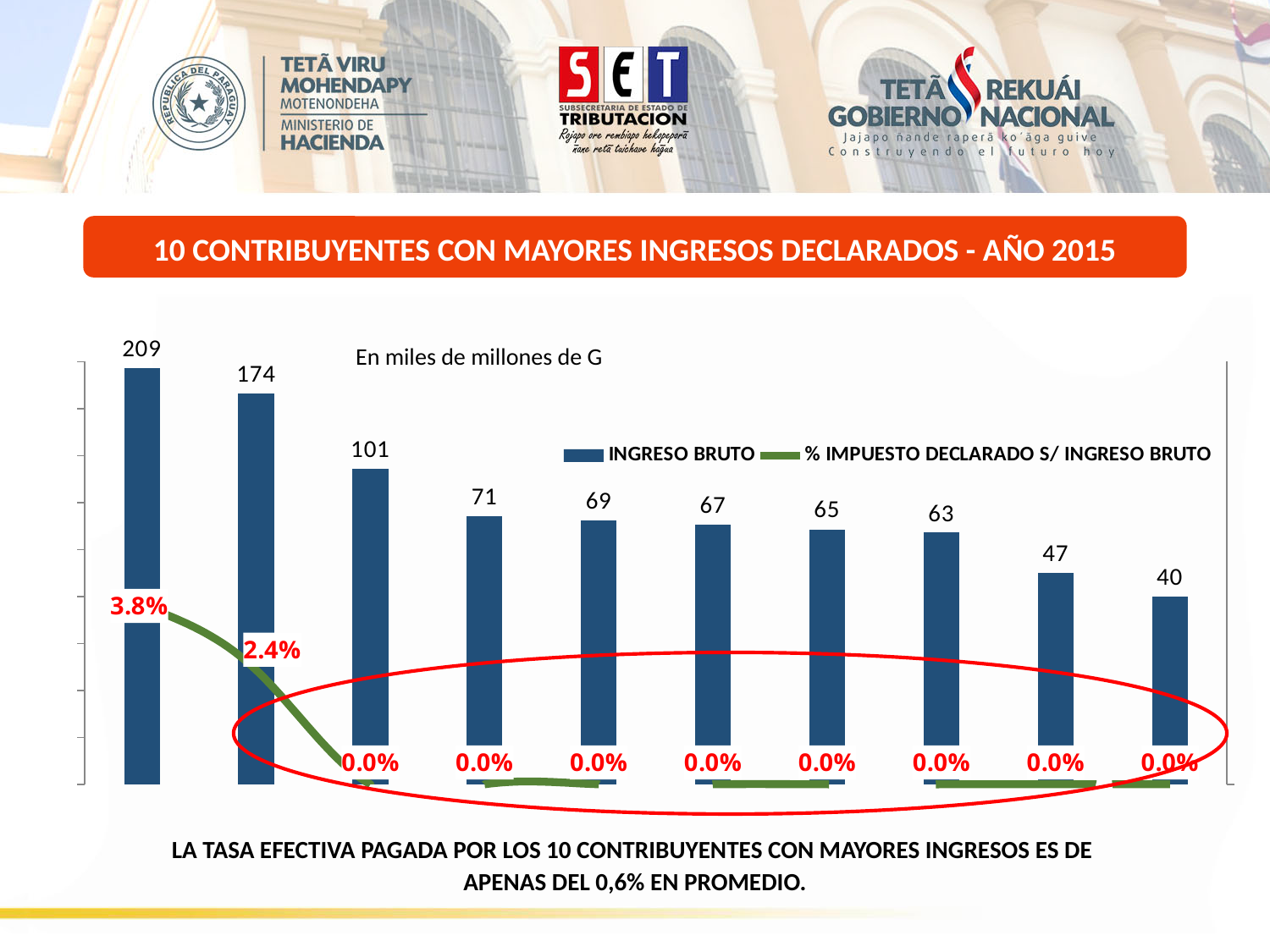
How many bars are plotted in the chart? 10 What is the INGRESO BRUTO value shown on the third bar from the left? 101 Do the INGRESO BRUTO values rise or fall from left to right across the chart? Fall What is the difference in INGRESO BRUTO between the first bar (209) and the second bar (174)? 35 What is the INGRESO BRUTO value of the shortest bar in the chart? 40 What % IMPUESTO DECLARADO S/ INGRESO BRUTO value is shown for the second contributor? 2.4% What kind of chart is used to show INGRESO BRUTO? Bar chart How many series does the legend list? 2 What is the INGRESO BRUTO value of the tallest bar in the chart? 209 What is the INGRESO BRUTO value shown on the second bar from the left? 174 Which is larger, the INGRESO BRUTO of the fourth bar or the ninth bar? The fourth bar (71) What % IMPUESTO DECLARADO S/ INGRESO BRUTO value is shown for the first (leftmost) contributor? 3.8%